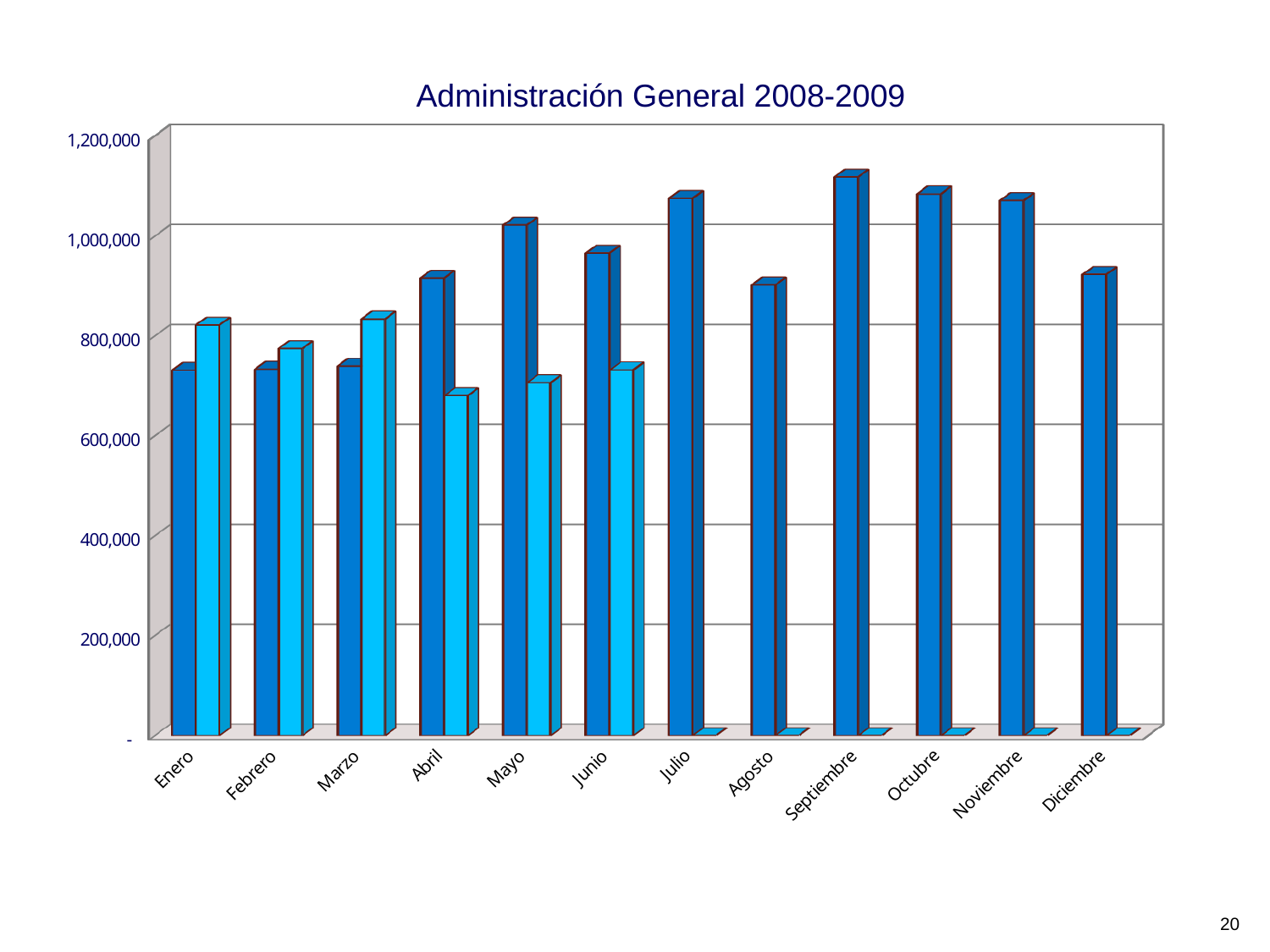
What kind of chart is shown on the slide? bar chart For Enero, which bar is taller, the dark blue bar or the light blue bar? the light blue bar Is the light blue bar for Abril greater or less than 800,000? less Which month has the taller dark blue bar, Septiembre or Diciembre? Septiembre What is the title of the chart? Administración General 2008-2009 Is the dark blue bar for Diciembre greater or less than 1,000,000? less Is the dark blue bar for Enero greater or less than 800,000? less For Abril, which bar is taller, the dark blue bar or the light blue bar? the dark blue bar How many months are shown on the x axis of the chart? 12 Which month has the tallest dark blue bar? Septiembre